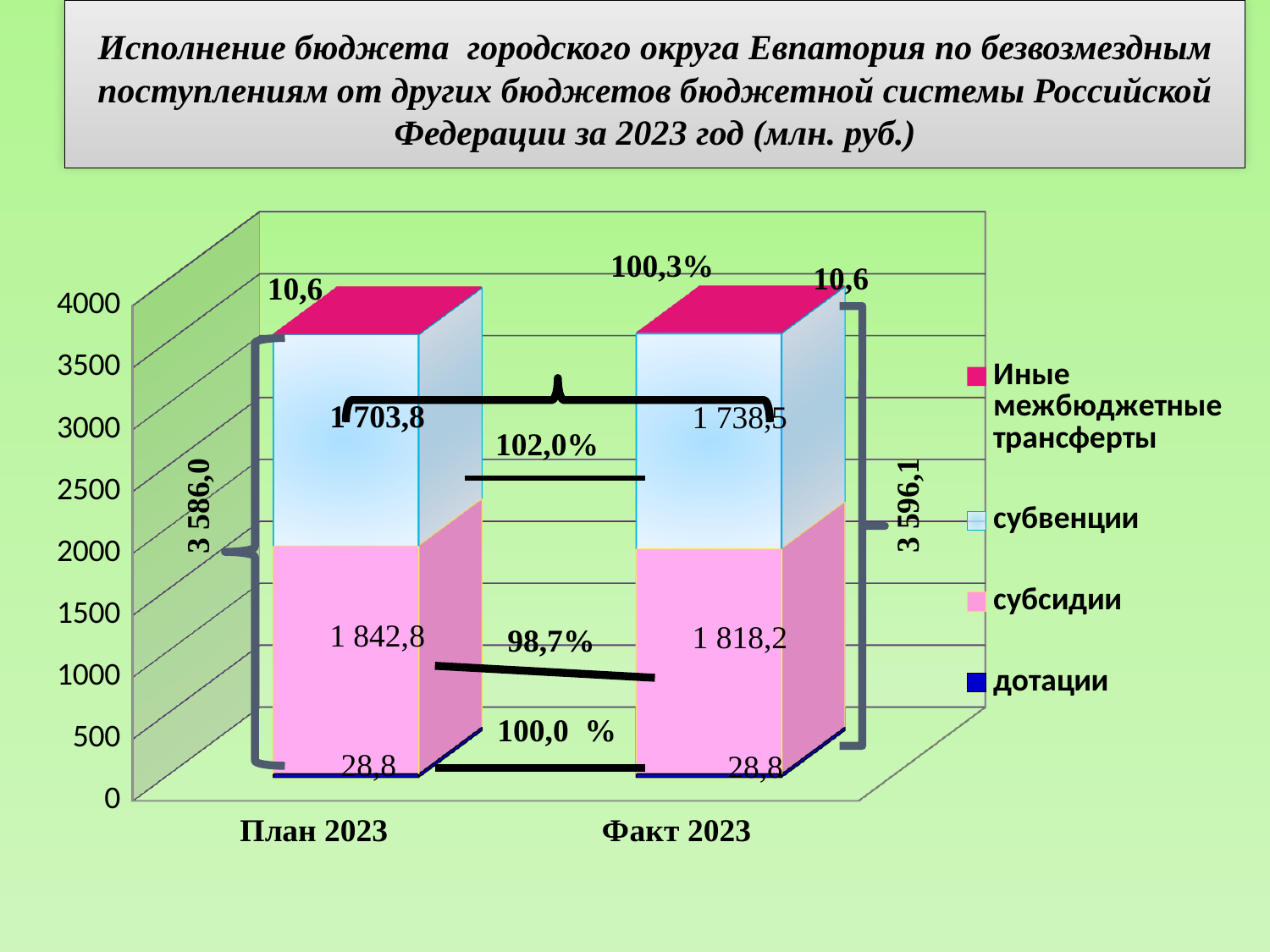
What is the value of субсидии for Факт 2023? 1 818,2 What is the value of субвенции for План 2023? 1 703,8 How many categories are shown on the x axis? 2 What is the difference between субсидии for План 2023 and субсидии for Факт 2023? 24,6 What is the value of дотации for План 2023? 28,8 What is the value of Иные межбюджетные трансферты for Факт 2023? 10,6 What is the total of the stacked bar for План 2023? 3 586,0 What kind of chart is shown on the slide? stacked bar chart Which is larger, субвенции for План 2023 or субвенции for Факт 2023? Факт 2023 What percentage is shown between the субсидии segments of the two bars? 98,7% What is the total of the stacked bar for Факт 2023? 3 596,1 How many series does the legend list? 4